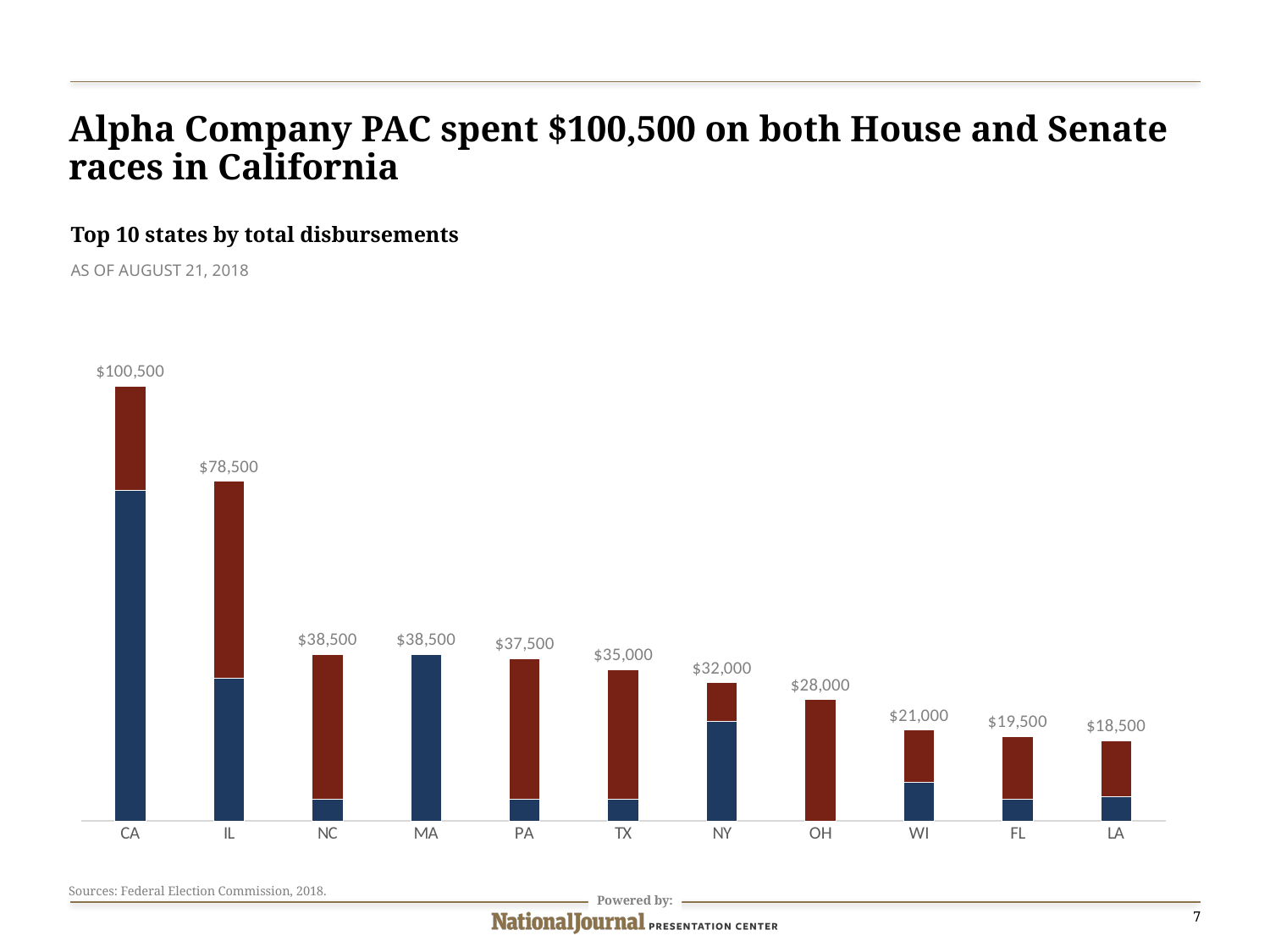
What is the difference between the total disbursements for CA and IL? $22,000 Which state has the highest total disbursement? CA What is the total disbursement shown for OH? $28,000 What is the total disbursement shown for CA? $100,500 How many states are shown on the chart? 11 Which has a larger total disbursement, PA or WI? PA What is the difference between the total disbursements for TX and NY? $3,000 Which state has the lowest total disbursement? LA What kind of chart is shown on the slide? Stacked bar chart What is the total disbursement shown for LA? $18,500 Do the total disbursements rise or fall moving from left to right across the states? Fall What is the total disbursement shown for IL? $78,500